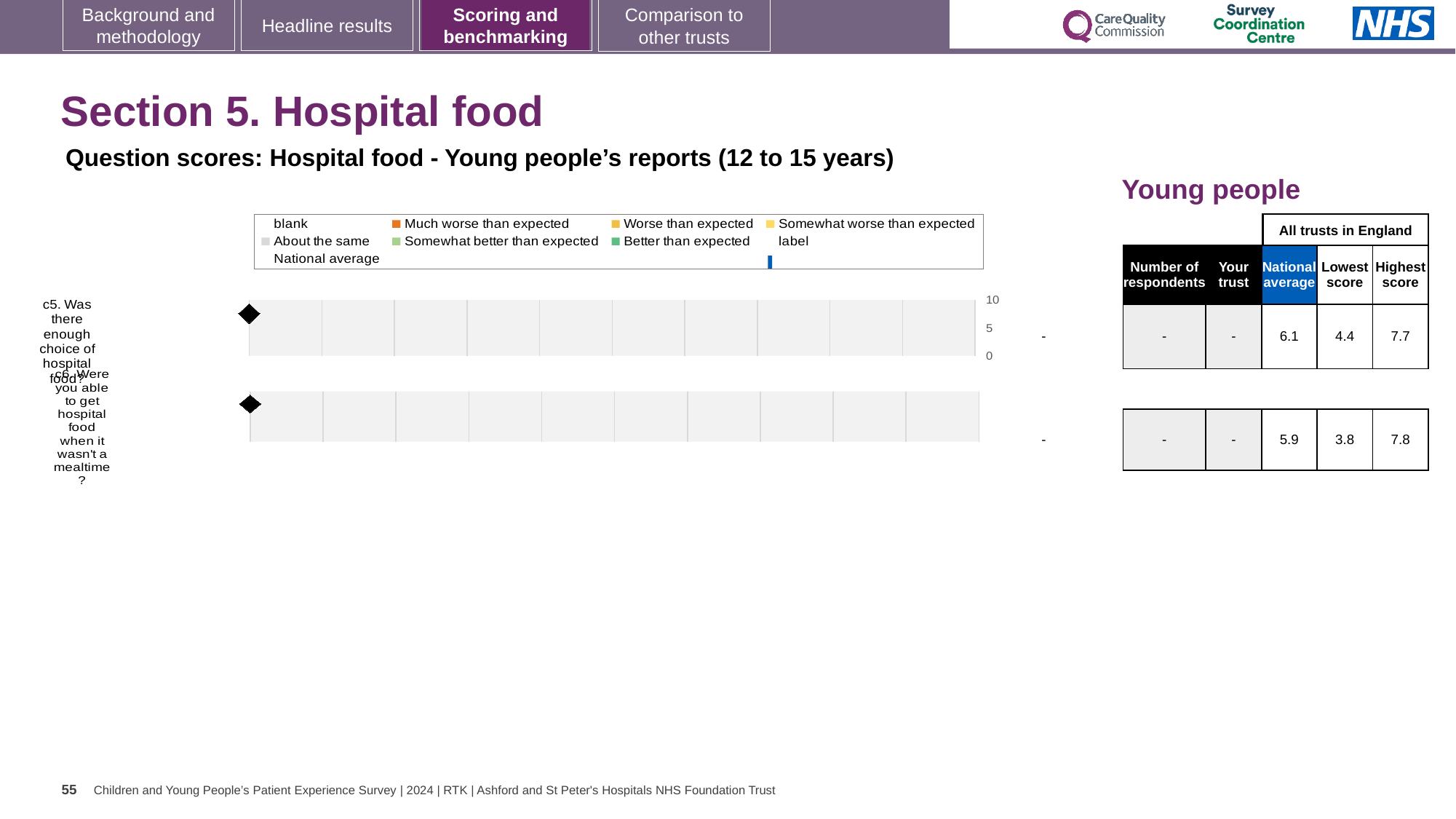
What is the difference between the highest and lowest scores for c6 'Were you able to get hospital food when it wasn't a mealtime?'? 4.0 What is the maximum value shown on the score axis of the hospital food chart? 10 What is the subtitle of the hospital food chart? Question scores: Hospital food - Young people's reports (12 to 15 years) What kind of chart is used to show the question scores for hospital food? bar chart What is the difference between the highest and lowest scores for c5 'Was there enough choice of hospital food?'? 3.3 What is the national average score for c5 'Was there enough choice of hospital food?'? 6.1 What is the lowest score across all trusts in England for c5 'Was there enough choice of hospital food?'? 4.4 What is the highest score across all trusts in England for c6 'Were you able to get hospital food when it wasn't a mealtime?'? 7.8 How many questions (categories) are plotted on the hospital food chart? 2 Which question has the lower lowest score across all trusts in England, c5 or c6? c6 What is the 'Your trust' score shown for c5 'Was there enough choice of hospital food?'? - Which question has the higher national average score, c5 or c6? c5